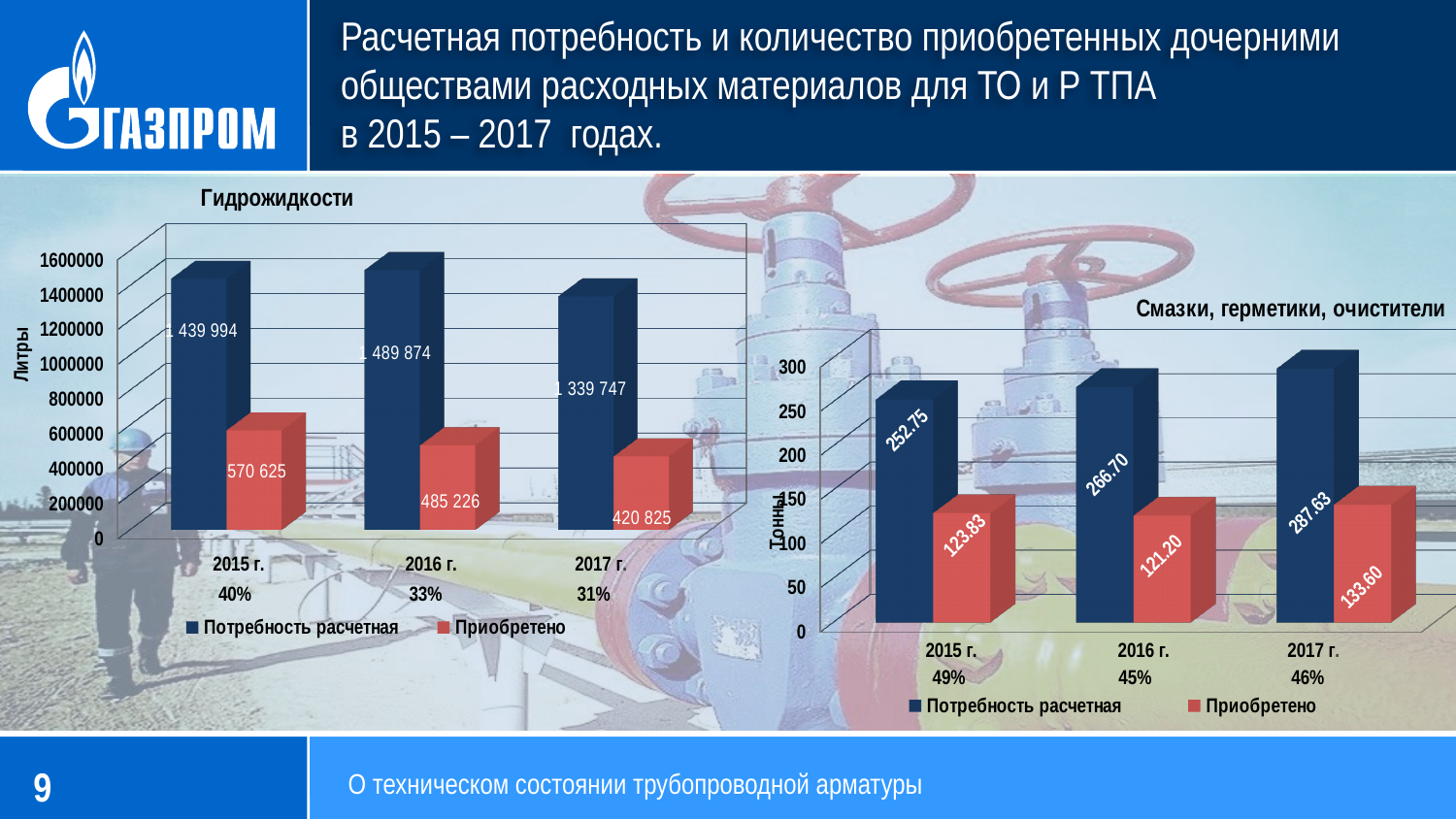
In the 'Гидрожидкости' chart, what is the value of 'Потребность расчетная' for 2015 г.? 1 439 994 In the 'Смазки, герметики, очистители' chart, which year has the highest 'Приобретено' value? 2017 г. In the 'Гидрожидкости' chart, which year has the lowest 'Приобретено' value? 2017 г. In the 'Гидрожидкости' chart, which year has the highest 'Потребность расчетная' value? 2016 г. What unit is shown on the vertical axis of the 'Гидрожидкости' chart? Литры In the 'Смазки, герметики, очистители' chart, what is the value of 'Приобретено' for 2016 г.? 121.20 In the 'Гидрожидкости' chart, what is the value of 'Приобретено' for 2017 г.? 420 825 In the 'Смазки, герметики, очистители' chart, what is the value of 'Потребность расчетная' for 2017 г.? 287.63 In the 'Смазки, герметики, очистители' chart, what is the difference between 'Потребность расчетная' and 'Приобретено' for 2015 г.? 128.92 In the 'Смазки, герметики, очистители' chart, how many series does the legend list? 2 In the 'Гидрожидкости' chart, does the 'Приобретено' series rise or fall from 2015 г. to 2017 г.? fall In the 'Гидрожидкости' chart, what is the difference between 'Потребность расчетная' and 'Приобретено' for 2016 г.? 1 004 648